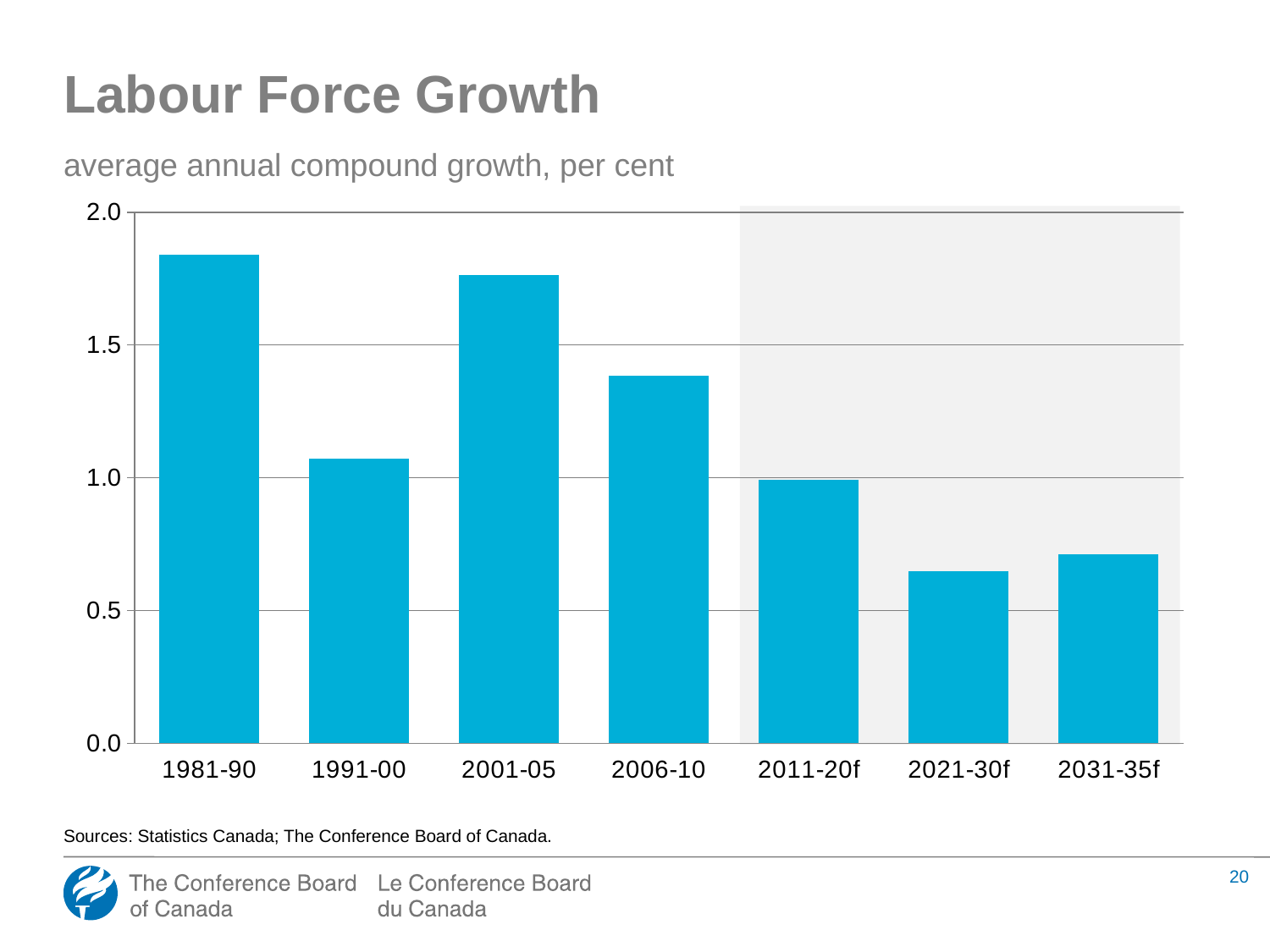
Is the value for 1981-90 greater or less than 1.5? greater Which is larger, the value for 1991-00 or the value for 2011-20f? 1991-00 Which period has the lowest labour force growth? 2021-30f Is the value for 2031-35f greater or less than 1.0? less Which period has the highest labour force growth? 1981-90 Which is larger, the value for 2001-05 or the value for 2006-10? 2001-05 What kind of chart is shown on the slide? bar chart How many periods are shown on the x axis of the chart? 7 Is the value for 2006-10 greater or less than 1.5? less What unit does the chart's subtitle say the values are measured in? average annual compound growth, per cent What is the title of the chart? Labour Force Growth